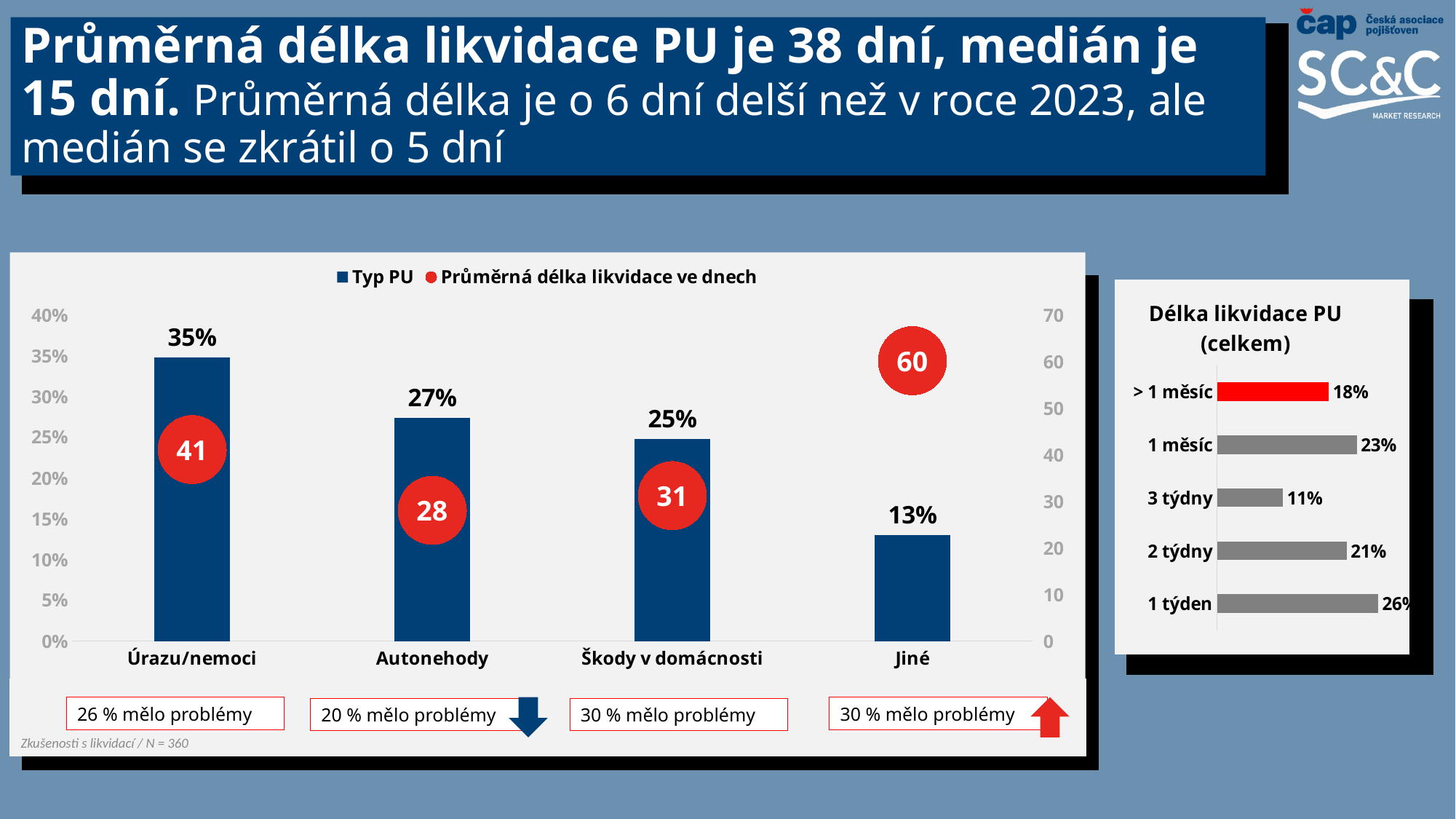
How many series does the legend of the left chart list? 2 In the left chart, which category has the lowest Typ PU share? Jiné What kind of chart is 'Délka likvidace PU (celkem)'? bar chart In the left chart, what is the average settlement length in days (Průměrná délka likvidace ve dnech) for Jiné? 60 In the chart titled 'Délka likvidace PU (celkem)', what is the value for 3 týdny? 11% In the chart titled 'Délka likvidace PU (celkem)', which category has the highest value? 1 týden How many categories are shown on the x axis of the left chart? 4 In the left chart, what is the average settlement length in days for Autonehody? 28 In the left chart, what is the difference in Typ PU share between Úrazu/nemoci and Škody v domácnosti? 10% In the left chart, what share of claims is shown for Úrazu/nemoci? 35% In the left chart, which category has the highest average settlement length in days? Jiné In the left chart, which has a longer average settlement length: Škody v domácnosti or Autonehody? Škody v domácnosti